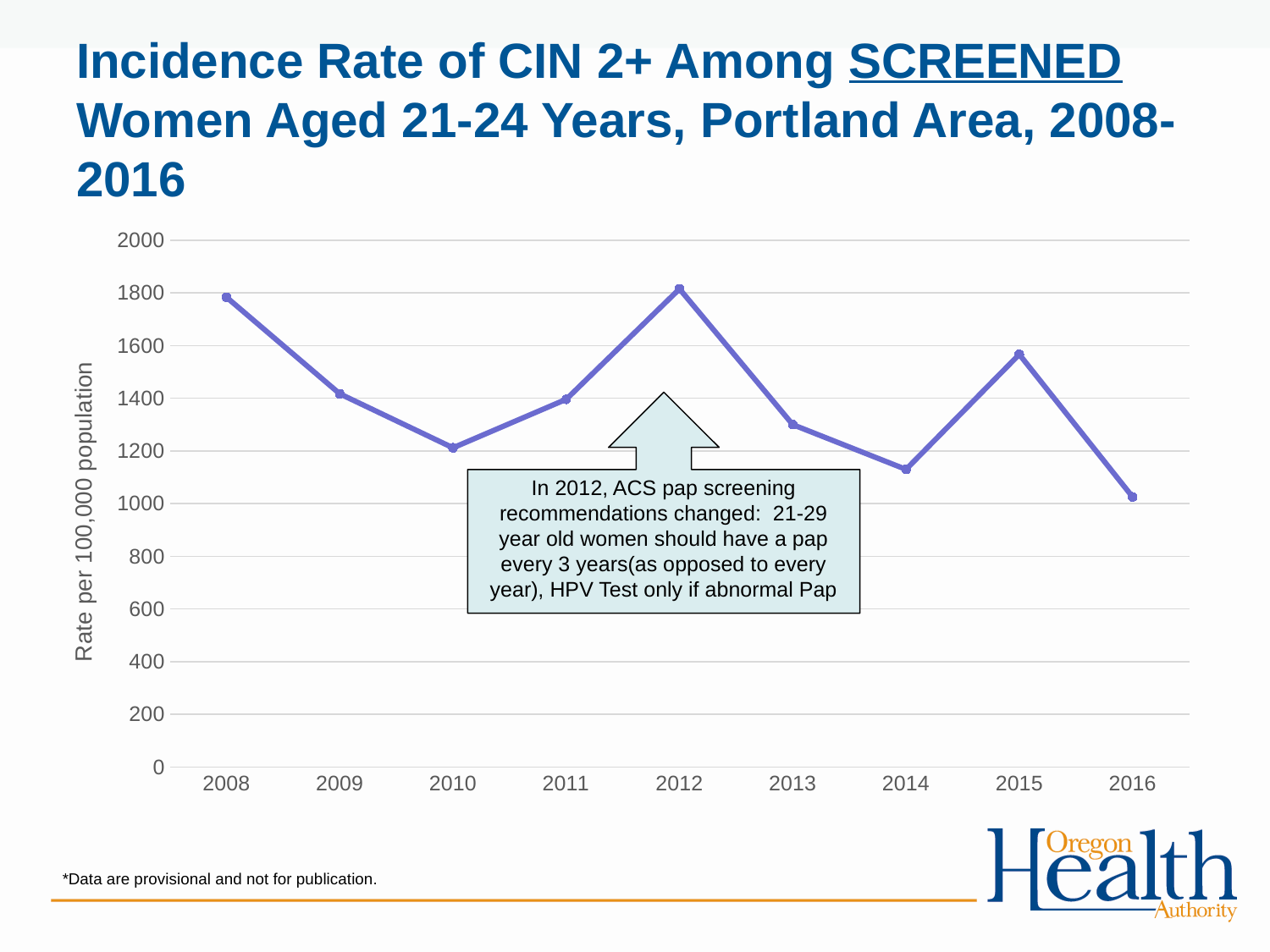
Is the value for 2015 greater or less than 1400? greater Is the value for 2010 greater or less than 1400? less Does the incidence rate rise or fall from 2015 to 2016? fall According to the annotation, in which year did ACS pap screening recommendations change? 2012 How many years are plotted on the x axis? 9 Which year has the lowest incidence rate? 2016 Is the value for 2014 greater or less than 1200? less What is the label on the y axis? Rate per 100,000 population What kind of chart is shown on the slide? line chart Which year has the highest incidence rate? 2012 Which year has a higher incidence rate, 2009 or 2013? 2009